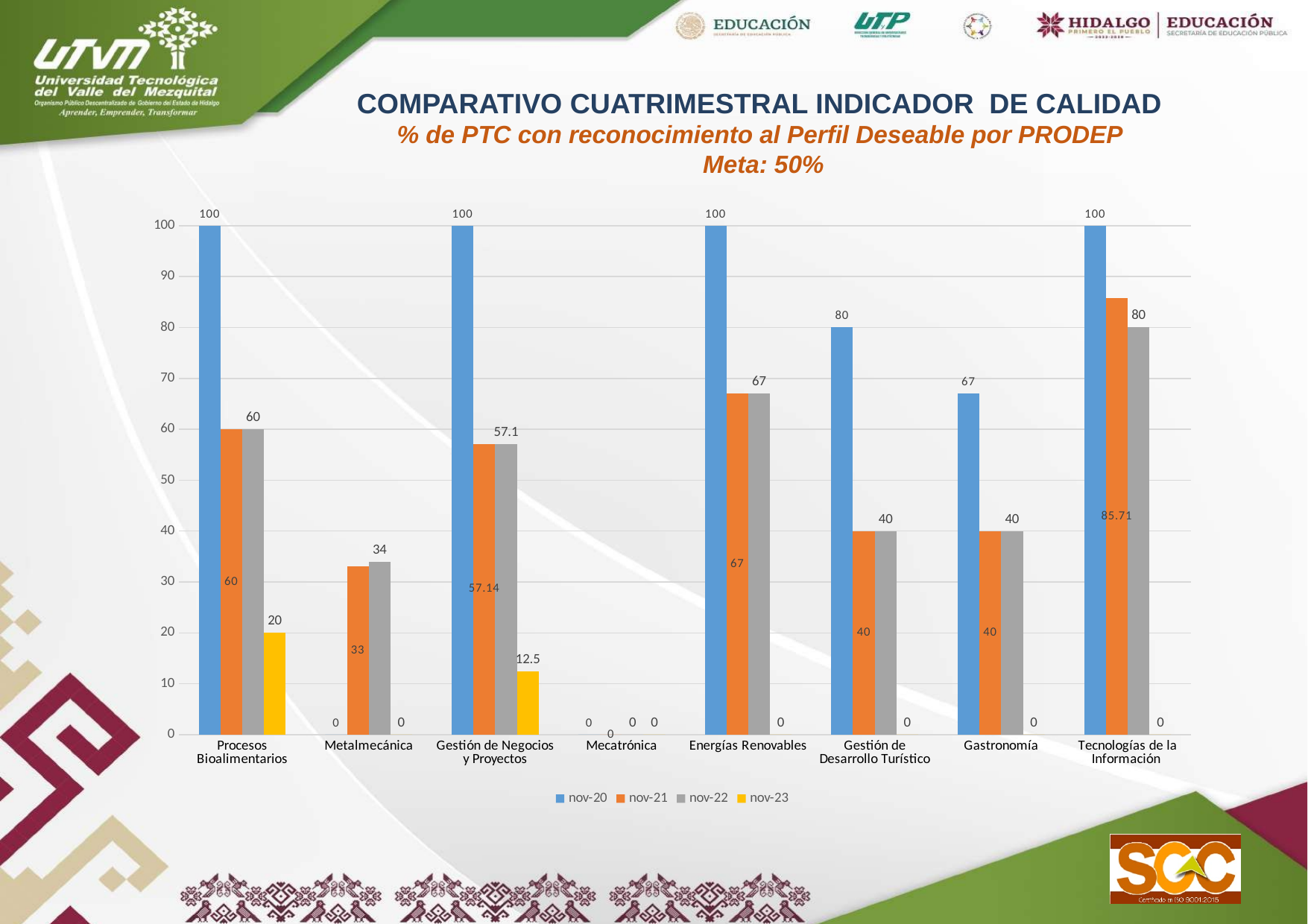
What is the nov-23 value for Procesos Bioalimentarios? 20 What is the nov-22 value for Metalmecánica? 34 Which category has the highest nov-23 value? Procesos Bioalimentarios What is the difference between the nov-20 and nov-21 values for Gestión de Desarrollo Turístico? 40 How many categories are shown on the x axis? 8 Which has the larger nov-22 value, Energías Renovables or Tecnologías de la Información? Tecnologías de la Información What kind of chart is shown on the slide? bar chart How many series does the legend list? 4 Which category has the highest nov-21 value? Tecnologías de la Información Is the nov-21 value for Gastronomía greater or less than 50? less What is the nov-21 value for Tecnologías de la Información? 85.71 What is the nov-23 value for Gestión de Negocios y Proyectos? 12.5